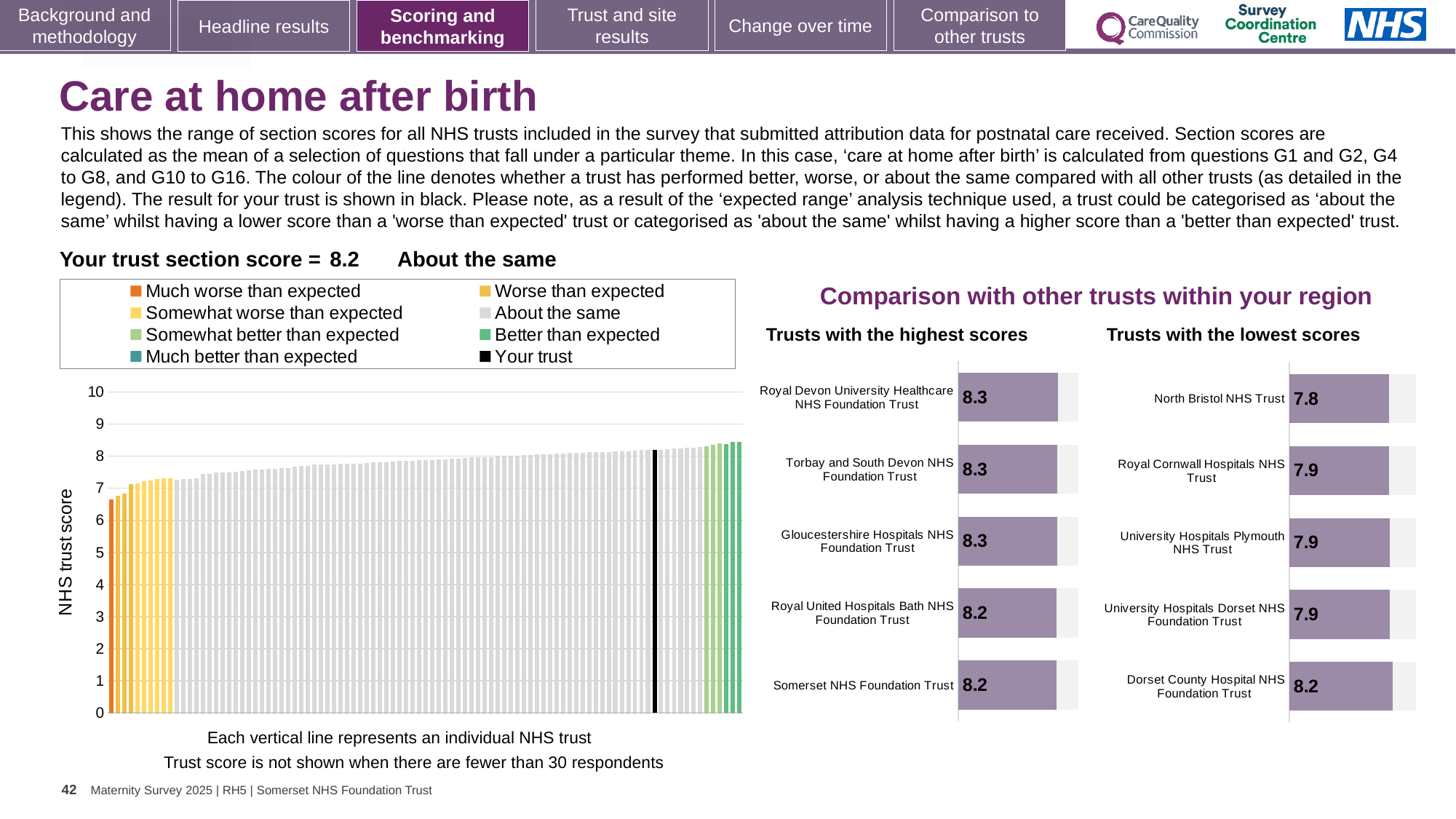
In the 'Trusts with the highest scores' chart, what is the score for Royal Devon University Healthcare NHS Foundation Trust? 8.3 In the 'Trusts with the lowest scores' chart, what is the score for North Bristol NHS Trust? 7.8 In the 'Trusts with the highest scores' chart, which has the higher score: Royal Devon University Healthcare NHS Foundation Trust or Somerset NHS Foundation Trust? Royal Devon University Healthcare NHS Foundation Trust What kind of chart is the large 'NHS trust score' chart on the left of the slide? Bar chart How many trusts are listed in the 'Trusts with the highest scores' chart? 5 In the large 'NHS trust score' chart on the left, do the bar values rise or fall from left to right? Rise In the 'Trusts with the lowest scores' chart, what is the difference between the scores of Dorset County Hospital NHS Foundation Trust and North Bristol NHS Trust? 0.4 How many entries does the legend above the large 'NHS trust score' chart list? 8 In the 'Trusts with the lowest scores' chart, what is the score for Dorset County Hospital NHS Foundation Trust? 8.2 In the 'Trusts with the lowest scores' chart, which trust has the lowest score? North Bristol NHS Trust In the 'Trusts with the lowest scores' chart, which trust has the highest score? Dorset County Hospital NHS Foundation Trust In the 'Trusts with the highest scores' chart, what is the score for Somerset NHS Foundation Trust? 8.2